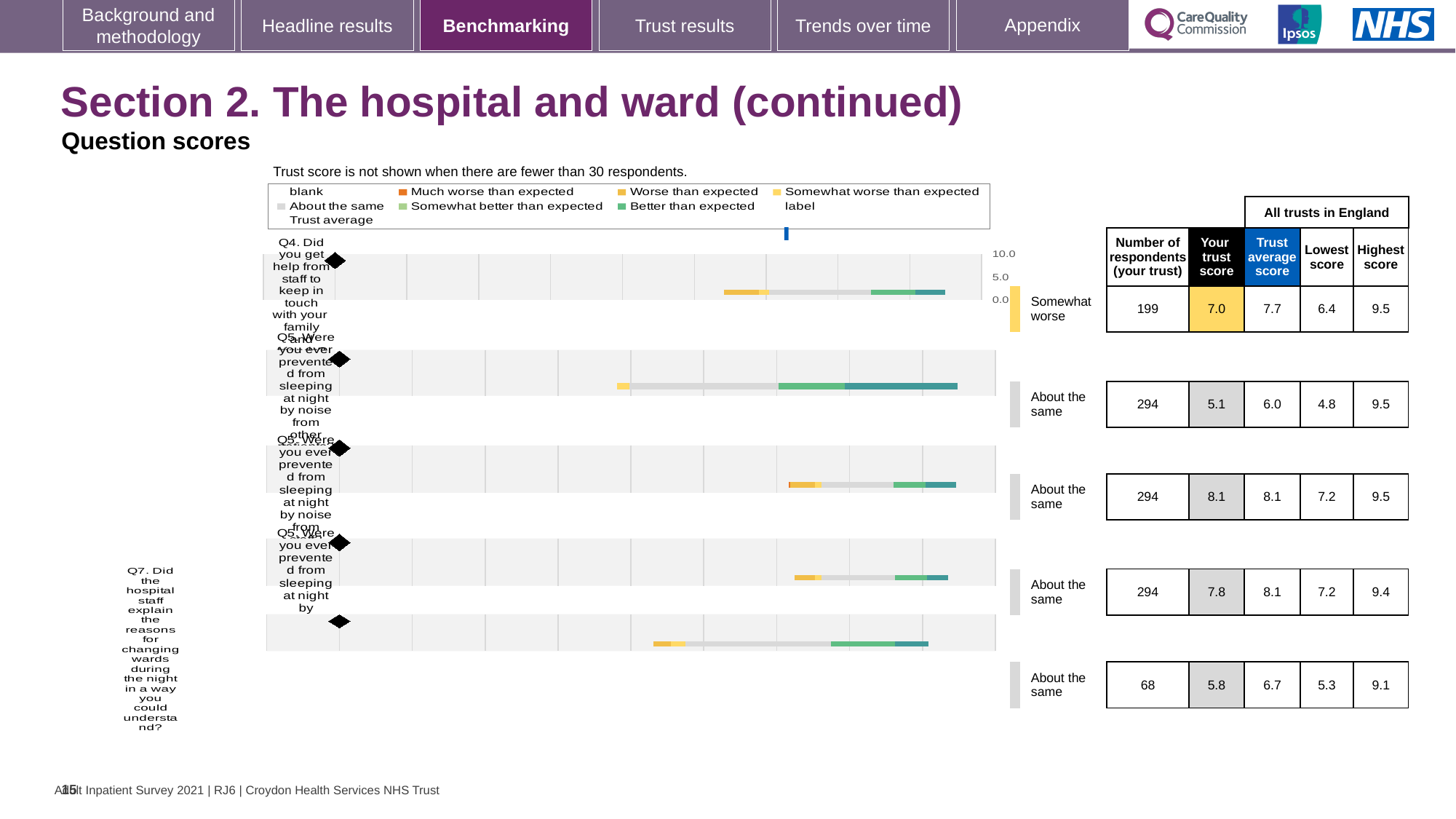
Which row has the highest 'Your trust score' in the table? the third row (8.1) Which row has the lowest 'Your trust score' in the table? the second row (5.1) Which has the larger 'Your trust score': Q4 (first row) or Q7 (last row)? Q4 What is the 'Your trust score' for the last row, Q7 (Did the hospital staff explain the reasons for changing wards during the night)? 5.8 What kind of chart is shown on the slide? bar chart What is the trust average score for Q4? 7.7 How many respondents does the table show for Q4? 199 Which benchmark category is shown for Q4? Somewhat worse What is the 'Your trust score' for Q4 (Did you get help from staff to keep in touch with your family)? 7.0 What is the difference between the trust average score and the 'Your trust score' for Q4? 0.7 What is the highest score across all trusts in England for Q7, the last row? 9.1 How many question rows (bars) are plotted in the chart? 5